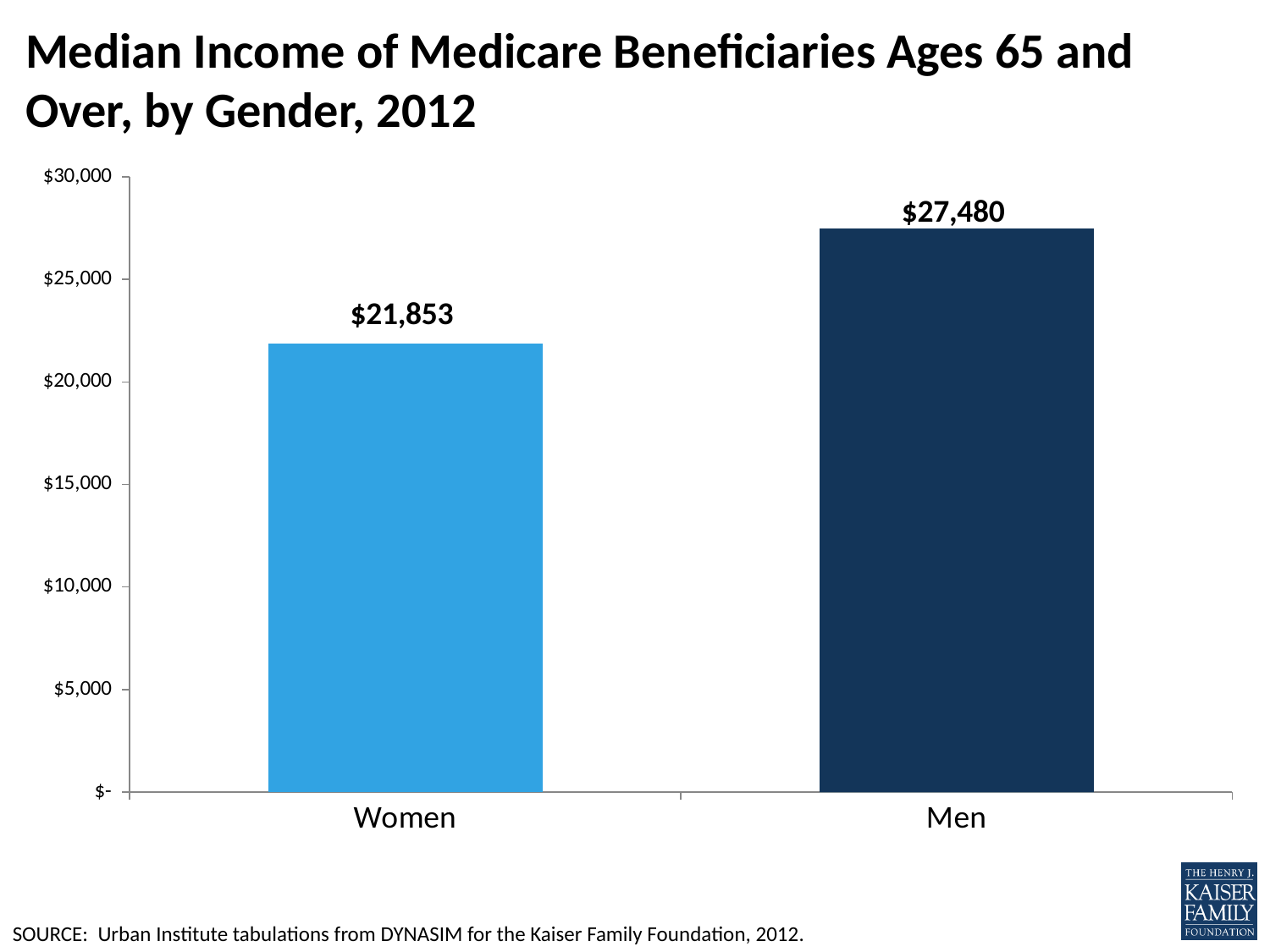
What is the median income for Men? $27,480 What is the highest value shown on the vertical axis? $30,000 Which category has the lowest median income? Women Is the median income for Women greater or less than $20,000? greater Which is larger, the median income for Women or for Men? Men How many categories are shown on the chart? 2 What kind of chart is shown on the slide? Bar chart Is the median income for Men greater or less than $30,000? less What is the difference between the median income of Men and Women? $5,627 Which category has the highest median income? Men What is the median income for Women? $21,853 What is the title of the chart? Median Income of Medicare Beneficiaries Ages 65 and Over, by Gender, 2012